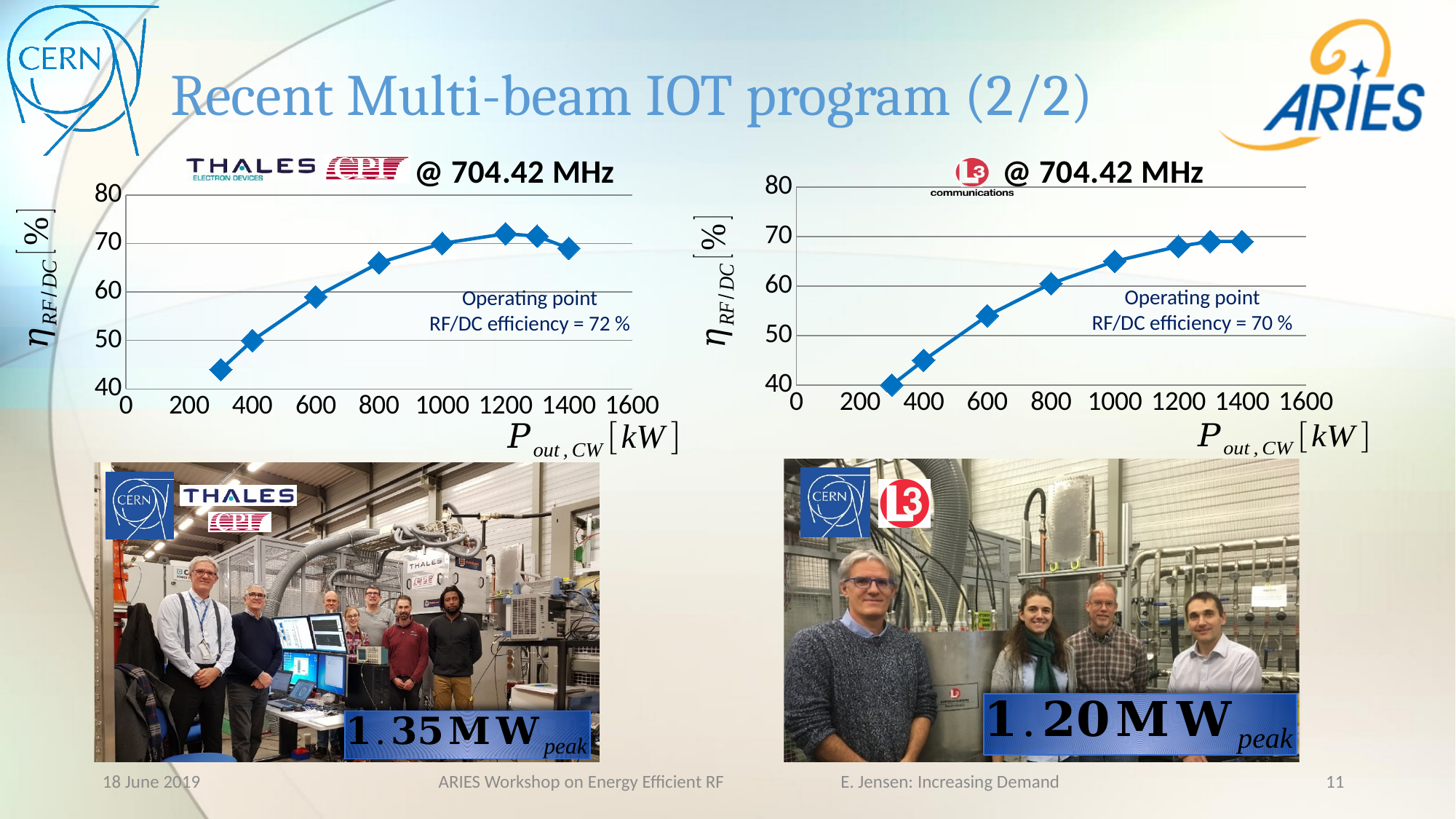
On the left chart (Thales/CPI), is the efficiency at 600 kW greater or less than 50? greater On the left chart (Thales/CPI), which has the higher efficiency: 300 kW or 1200 kW? 1200 kW On the right chart (L3), does the efficiency generally rise or fall as output power increases? rise On the right chart (L3), what RF/DC efficiency is stated for the operating point? 70 % What kind of chart is the right chart (L3 @ 704.42 MHz)? line chart How many data points are plotted on the left chart (Thales/CPI)? 8 What kind of chart is the left chart (Thales/CPI @ 704.42 MHz)? line chart How many data points are plotted on the right chart (L3)? 8 On the right chart (L3), is the efficiency at 800 kW greater or less than 70? less On the left chart (Thales/CPI), what RF/DC efficiency is stated for the operating point? 72 % On the right chart (L3), is the efficiency at 400 kW greater or less than 50? less